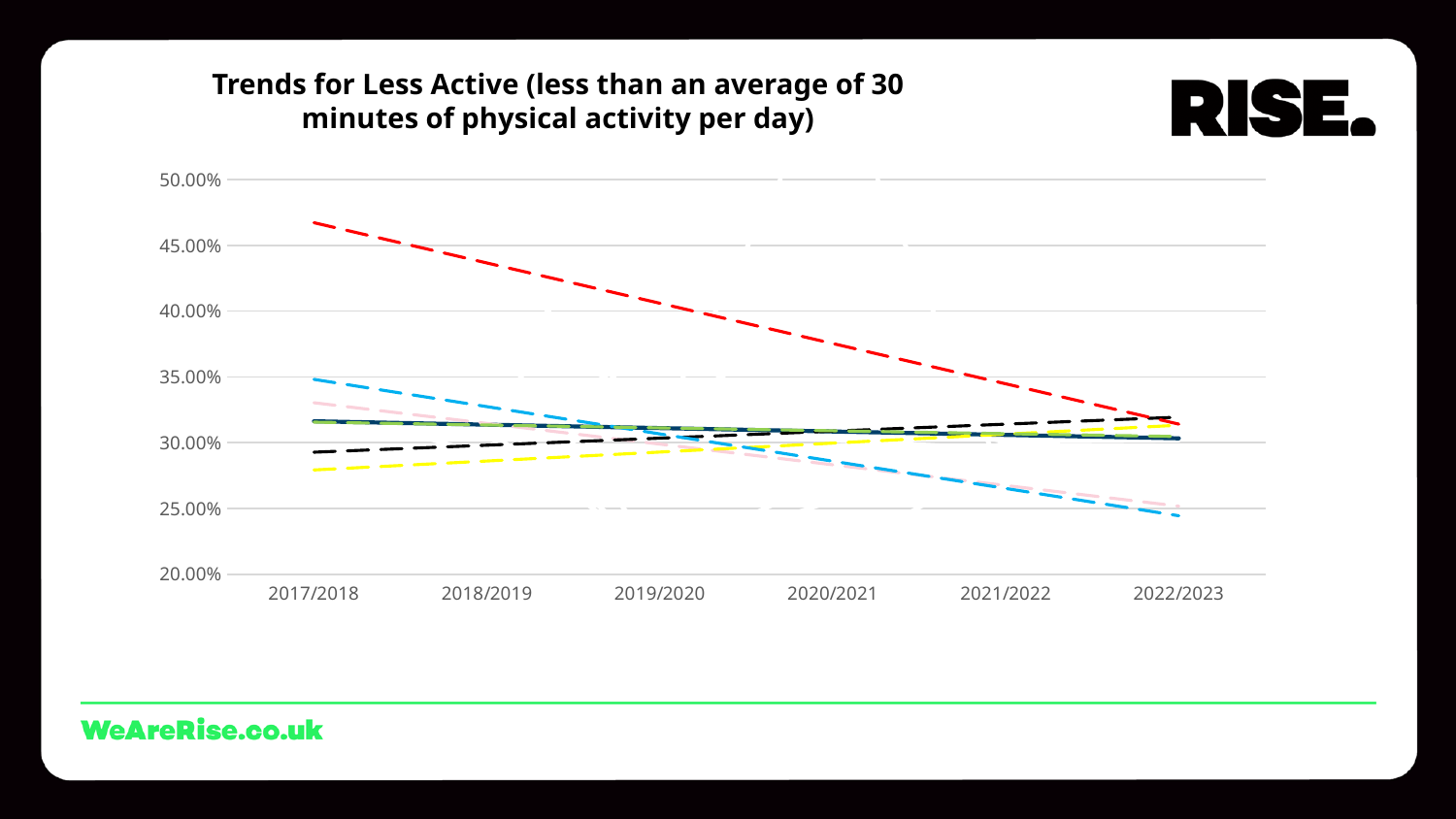
Does the black dashed line rise or fall from 2017/2018 to 2022/2023? rise How many time periods are shown along the x axis? 6 Is the value of the red line at 2017/2018 greater or less than 45.00%? greater Which coloured line has the highest value at 2017/2018? red Is the value of the red line at 2022/2023 greater or less than 30.00%? greater What kind of chart is shown on the slide? line chart Which coloured line has the lowest value at 2017/2018? yellow Does the yellow dashed line rise or fall from 2017/2018 to 2022/2023? rise Does the light blue dashed line rise or fall from 2017/2018 to 2022/2023? fall Is the value of the yellow line at 2017/2018 greater or less than 30.00%? less What is the title of the chart? Trends for Less Active (less than an average of 30 minutes of physical activity per day)